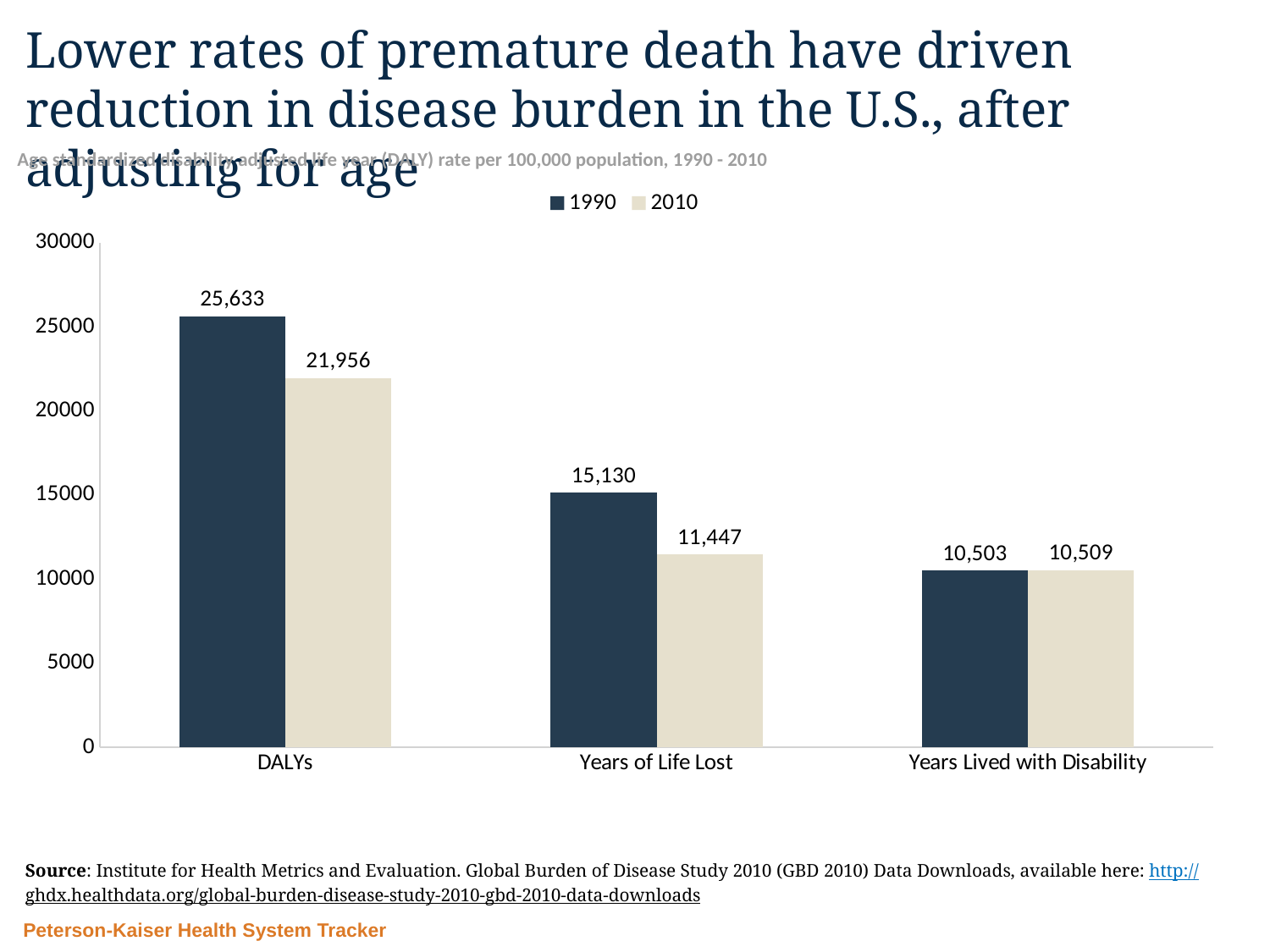
What is the 2010 value for Years Lived with Disability? 10,509 What is the difference between the 1990 and 2010 values for Years of Life Lost? 3,683 What is the difference between the 1990 and 2010 values for DALYs? 3,677 Which category has the highest 1990 value? DALYs What is the 2010 value for Years of Life Lost? 11,447 Which is larger, the 1990 value for Years of Life Lost or the 2010 value for DALYs? 2010 value for DALYs How many series does the legend list? 2 Which category has the lowest 2010 value? Years Lived with Disability What kind of chart is shown on the slide? Bar chart Is the 1990 value for Years of Life Lost greater or less than 15000? greater What is the 1990 value for DALYs? 25,633 How many categories are shown on the x axis? 3